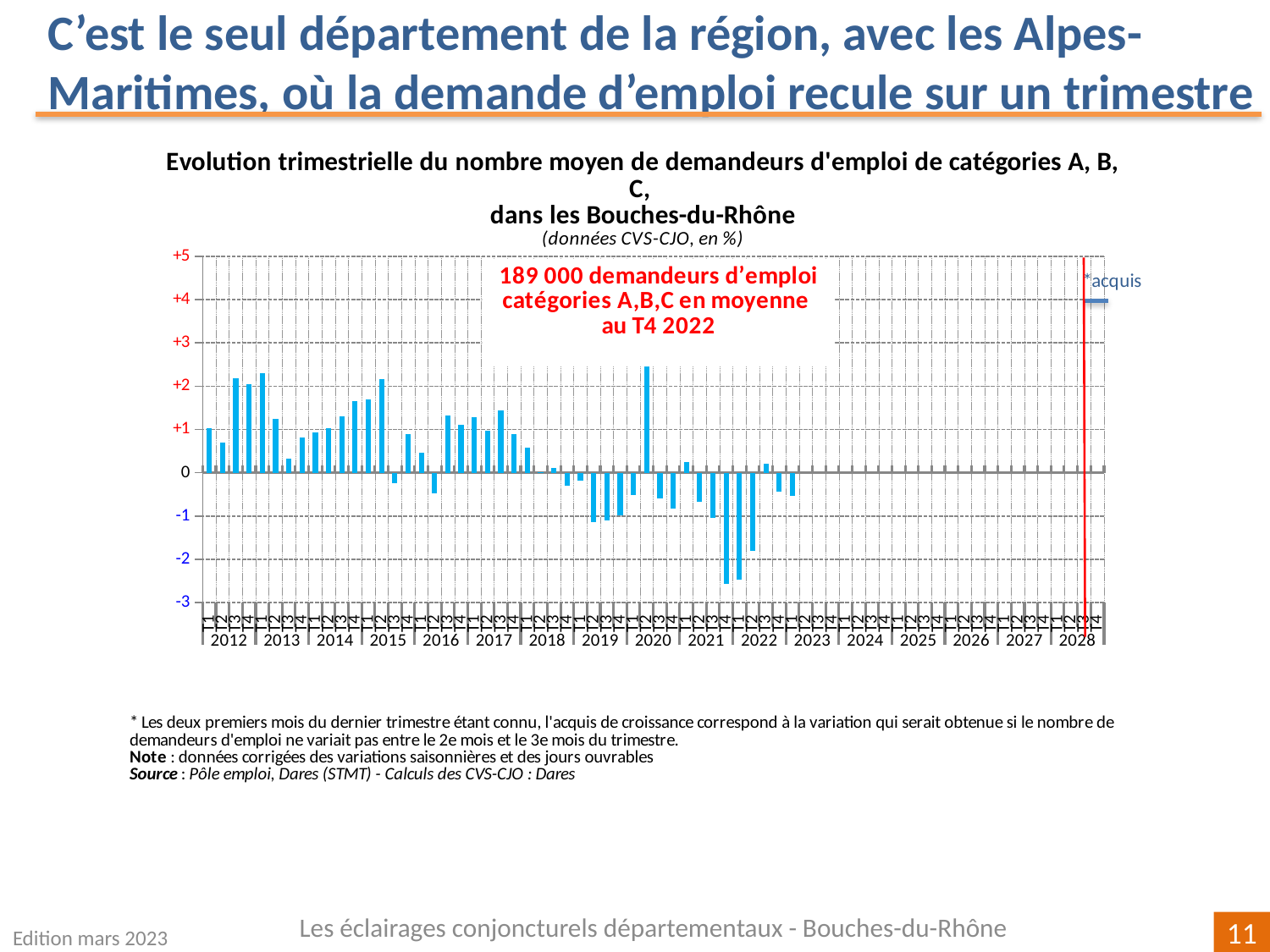
Is the value for T1 2020 greater or less than 0? less Is the value for T3 2021 greater or less than -2? greater Which is larger, the value for T1 2012 or the value for T3 2021? T1 2012 According to the annotation on the chart, how many demandeurs d'emploi catégories A,B,C were there on average in T4 2022? 189 000 Which is larger, the value for T1 2020 or the value for T2 2020? T2 2020 In which year does the lowest bar on the chart occur? 2021 What kind of chart is shown on the slide? bar chart Is the value for T1 2012 greater or less than 0? greater What is the title of the chart? Evolution trimestrielle du nombre moyen de demandeurs d'emploi de catégories A, B, C, dans les Bouches-du-Rhône Do the values rise or fall from T1 2021 to T3 2021? fall